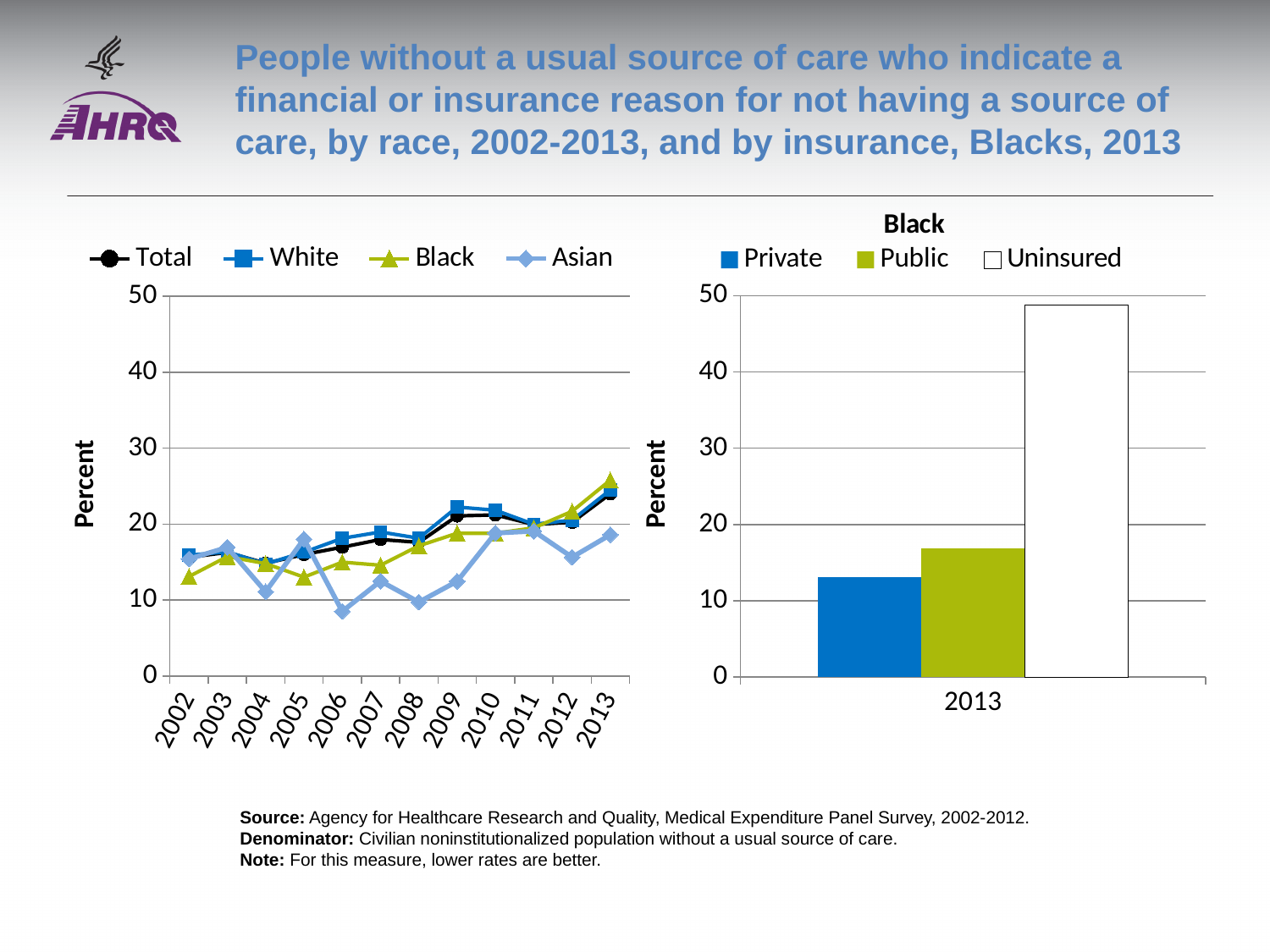
What kind of chart is the chart on the left of the slide? line chart In the chart on the left, is the value for Black in 2013 greater or less than 20? greater In the chart on the left, does the Black series rise or fall overall from 2002 to 2013? rise In the chart on the left, is the value for Asian in 2006 greater or less than 10? less In the chart on the left, how many series does the legend list? 4 What kind of chart is the chart titled "Black" on the right of the slide? bar chart In the chart titled "Black", how many series does the legend list? 3 In the chart titled "Black", which insurance group has the lowest value? Private In the chart on the left, how many years are shown on the x axis? 12 In the chart titled "Black", is the value for Uninsured greater or less than 40? greater In the chart titled "Black", which insurance group has the highest value? Uninsured